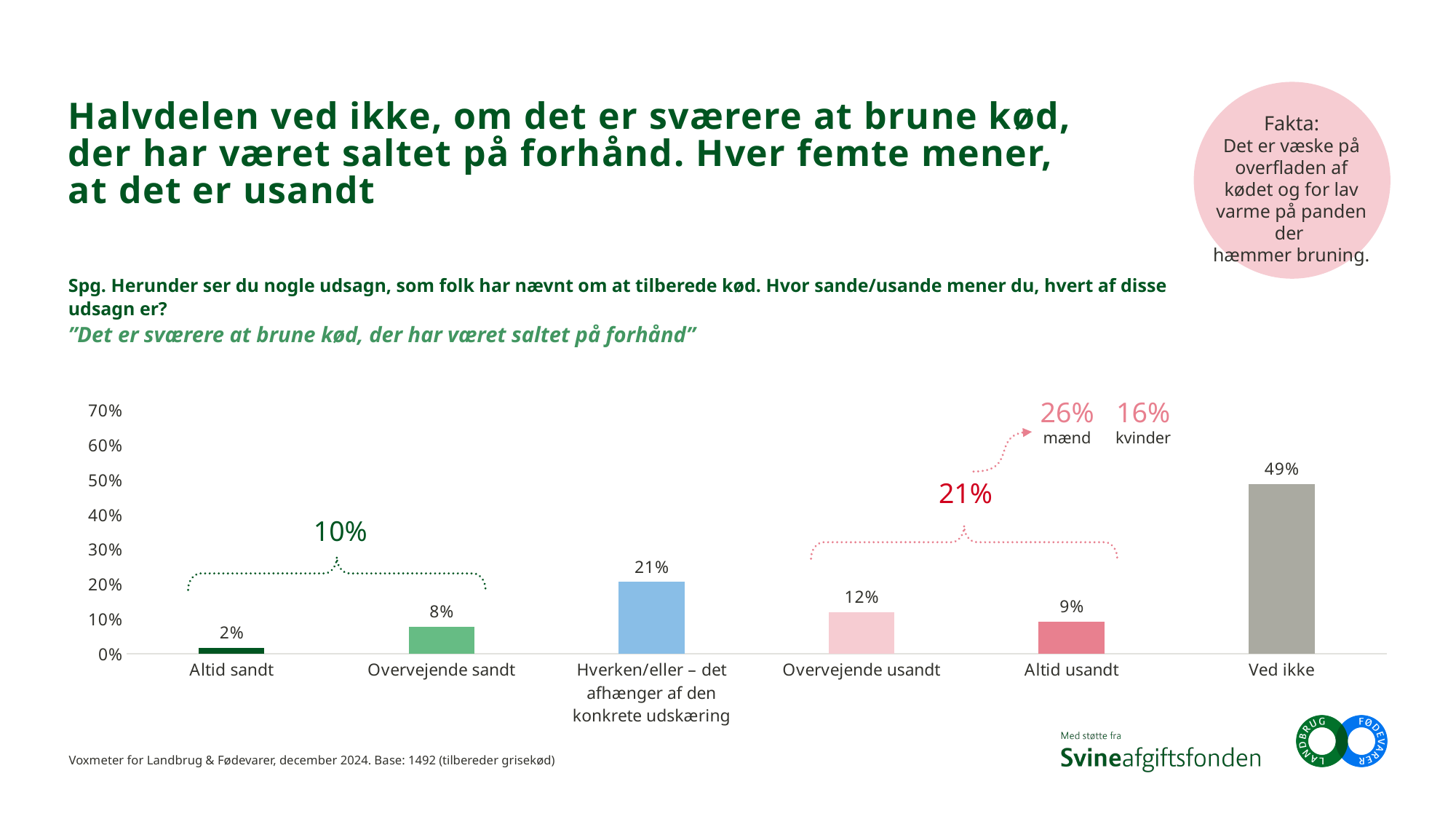
Which category has the highest value? Ved ikke How many categories are shown on the x axis? 6 What is the value for "Hverken/eller – det afhænger af den konkrete udskæring"? 21% What is the value for "Overvejende usandt"? 12% Which category has the lowest value? Altid sandt According to the annotation, what share of men (mænd) think the statement is untrue? 26% What is the difference between the values for "Ved ikke" and "Altid usandt"? 40% What is the value for "Ved ikke"? 49% What is the combined share for "Overvejende usandt" and "Altid usandt" shown above the bracket? 21% What is the value for "Altid sandt"? 2% What kind of chart is shown on the slide? Bar chart Which is larger, the value for "Overvejende sandt" or the value for "Overvejende usandt"? Overvejende usandt